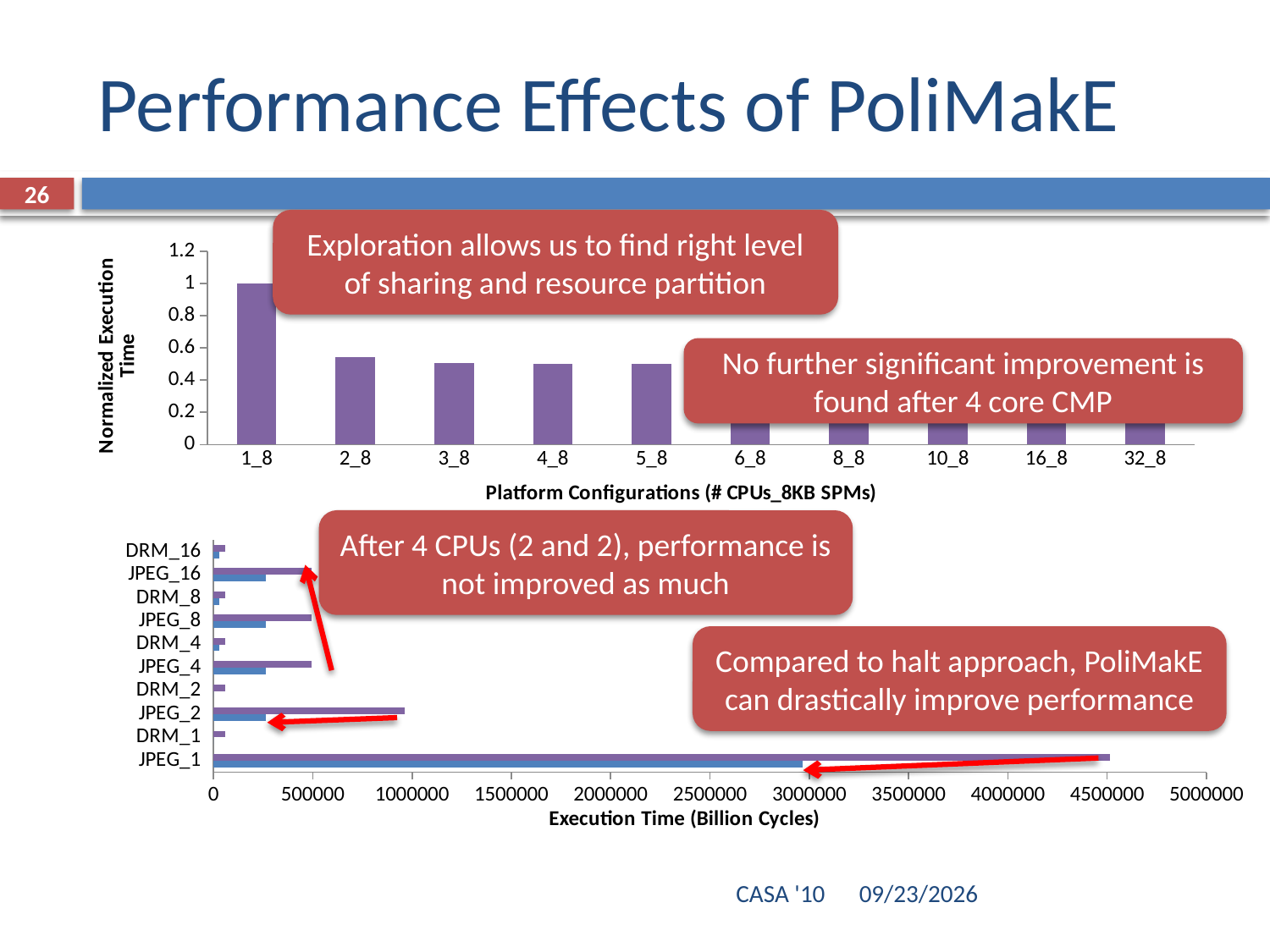
What type of chart is the top chart on the slide? bar chart In the top chart, how many platform configurations are shown on the x axis? 10 In the bottom chart, which category has the longest bar? JPEG_1 What type of chart is the bottom chart on the slide? bar chart In the top chart, what is the normalized execution time for configuration 1_8? 1 In the top chart, which platform configuration has the highest normalized execution time? 1_8 In the bottom chart, how many categories are listed on the vertical axis? 10 In the top chart, is the normalized execution time for 3_8 greater or less than 0.6? less In the top chart, is the normalized execution time for 2_8 greater or less than 0.4? greater What is the x-axis title of the top chart? Platform Configurations (# CPUs_8KB SPMs) In the top chart, which has a higher normalized execution time, 1_8 or 2_8? 1_8